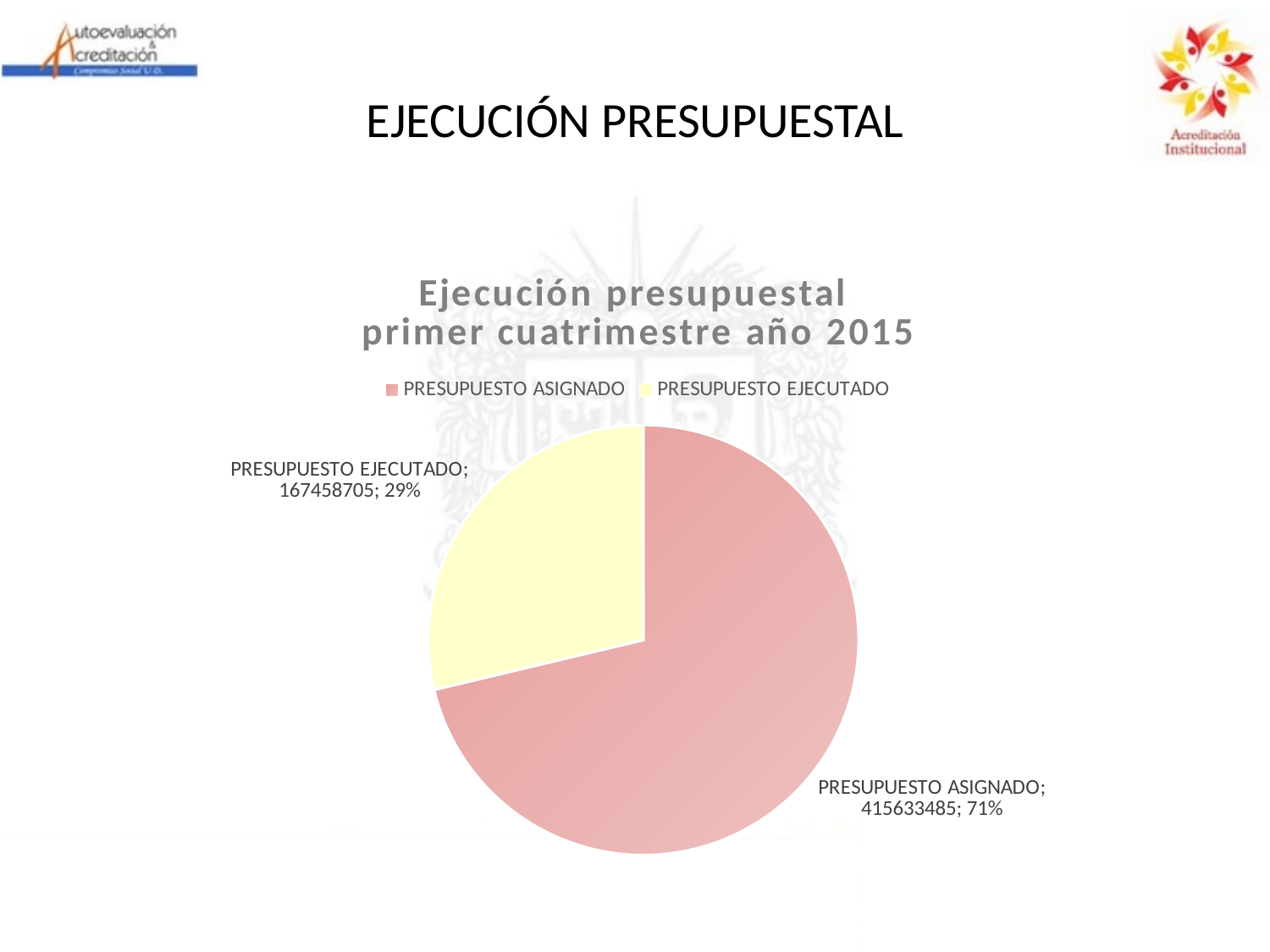
What is the title of the chart? Ejecución presupuestal primer cuatrimestre año 2015 What type of chart is shown on the slide? pie chart Which slice is the largest? PRESUPUESTO ASIGNADO What is the value for PRESUPUESTO EJECUTADO? 167458705 What share of the pie does PRESUPUESTO ASIGNADO represent? 71% How many slices does the pie chart have? 2 How many entries does the legend list? 2 Which slice is the smallest? PRESUPUESTO EJECUTADO What is the difference between the PRESUPUESTO ASIGNADO and PRESUPUESTO EJECUTADO values? 248174780 Which is larger, PRESUPUESTO EJECUTADO or PRESUPUESTO ASIGNADO? PRESUPUESTO ASIGNADO What share of the pie does PRESUPUESTO EJECUTADO represent? 29% What is the value for PRESUPUESTO ASIGNADO? 415633485